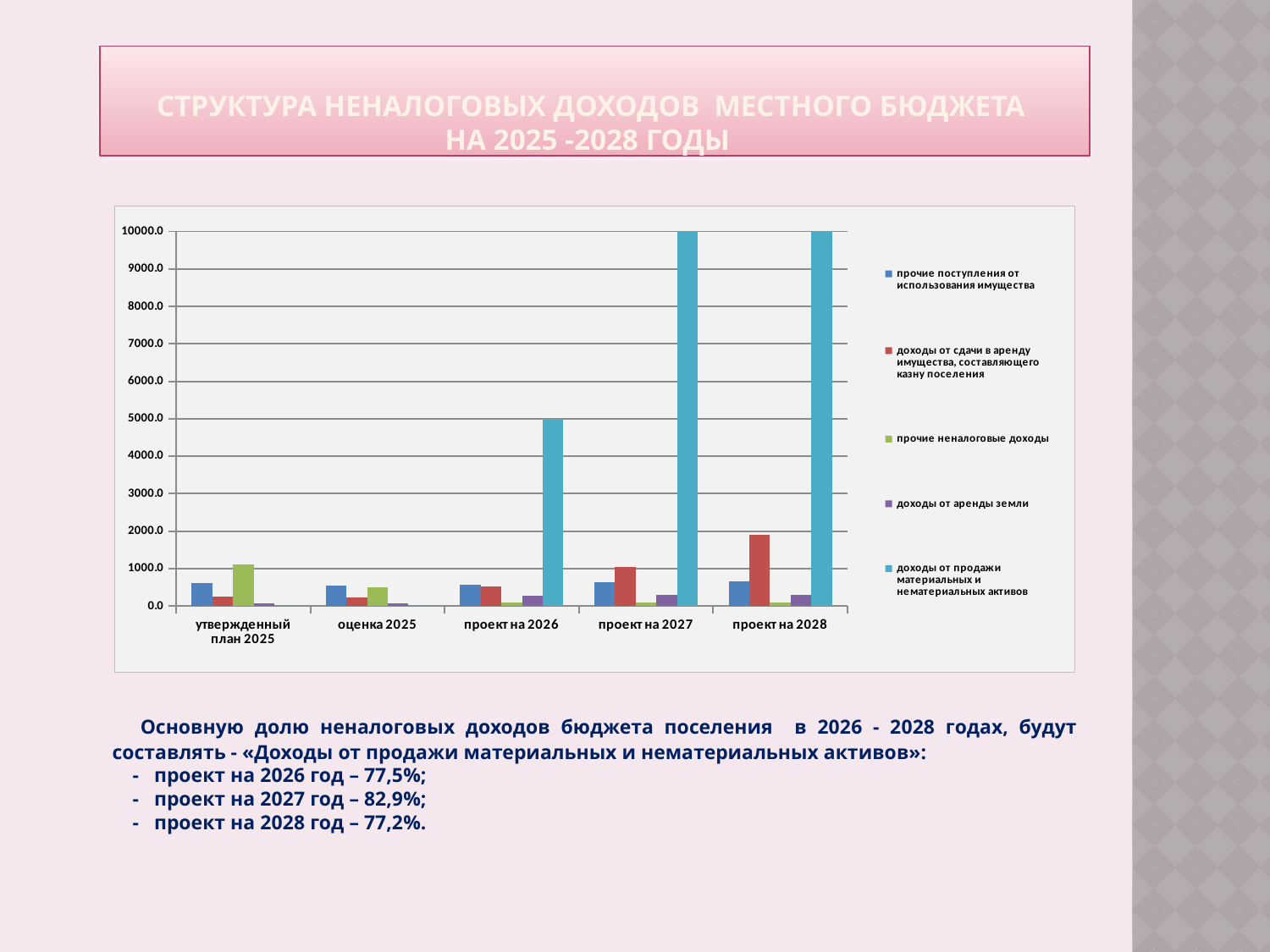
Which series has the highest value in the «проект на 2026» category? доходы от продажи материальных и нематериальных активов Which series is shown in red in the chart legend? доходы от сдачи в аренду имущества, составляющего казну поселения Is the value of «прочие поступления от использования имущества» for «утвержденный план 2025» greater or less than 1000.0? less What kind of chart is shown on the slide? bar chart Is the value of «доходы от продажи материальных и нематериальных активов» for «проект на 2026» greater or less than 4000.0? greater In the «проект на 2028» category, which is larger: «доходы от сдачи в аренду имущества, составляющего казну поселения» or «прочие поступления от использования имущества»? доходы от сдачи в аренду имущества, составляющего казну поселения Is the value of «доходы от сдачи в аренду имущества, составляющего казну поселения» for «проект на 2028» greater or less than 1000.0? greater What is the title of the slide containing the chart? СТРУКТУРА НЕНАЛОГОВЫХ ДОХОДОВ МЕСТНОГО БЮДЖЕТА НА 2025 -2028 ГОДЫ How many categories are shown along the x axis of the chart? 5 How many series does the chart legend list? 5 In the «утвержденный план 2025» category, which is larger: «прочие неналоговые доходы» or «доходы от аренды земли»? прочие неналоговые доходы